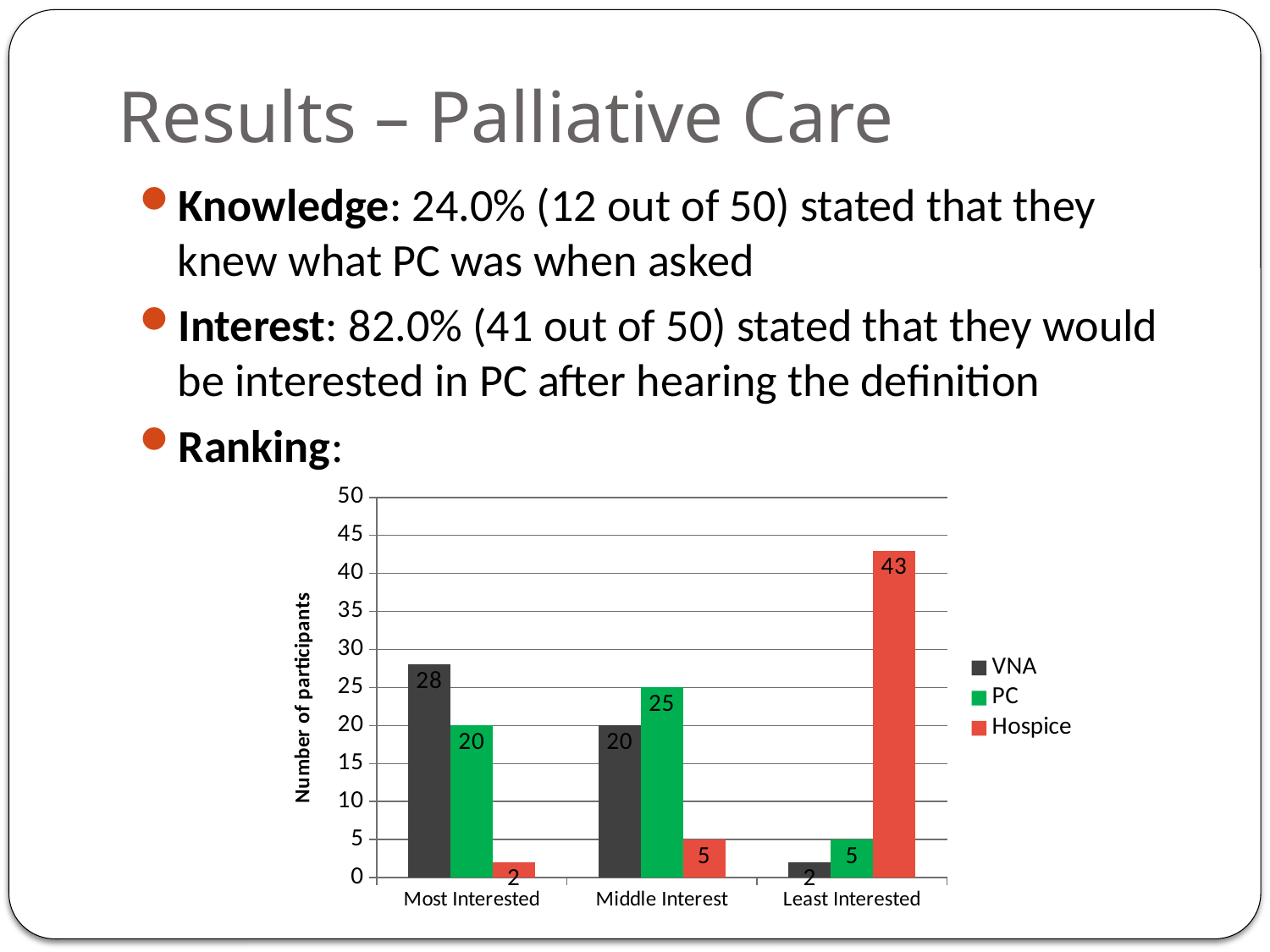
What is the difference between the VNA and PC values in the Most Interested category? 8 What is the value for VNA in the Most Interested category? 28 How many categories are shown on the x axis? 3 Which series has the lowest value in the Most Interested category? Hospice What is the label of the y axis? Number of participants What kind of chart is shown on the slide? Bar chart Which series has the highest value in the Least Interested category? Hospice Which is larger in the Middle Interest category, VNA or PC? PC What is the value for PC in the Middle Interest category? 25 Do the Hospice values rise or fall from Most Interested to Least Interested? Rise What is the value for Hospice in the Least Interested category? 43 How many series does the legend list? 3